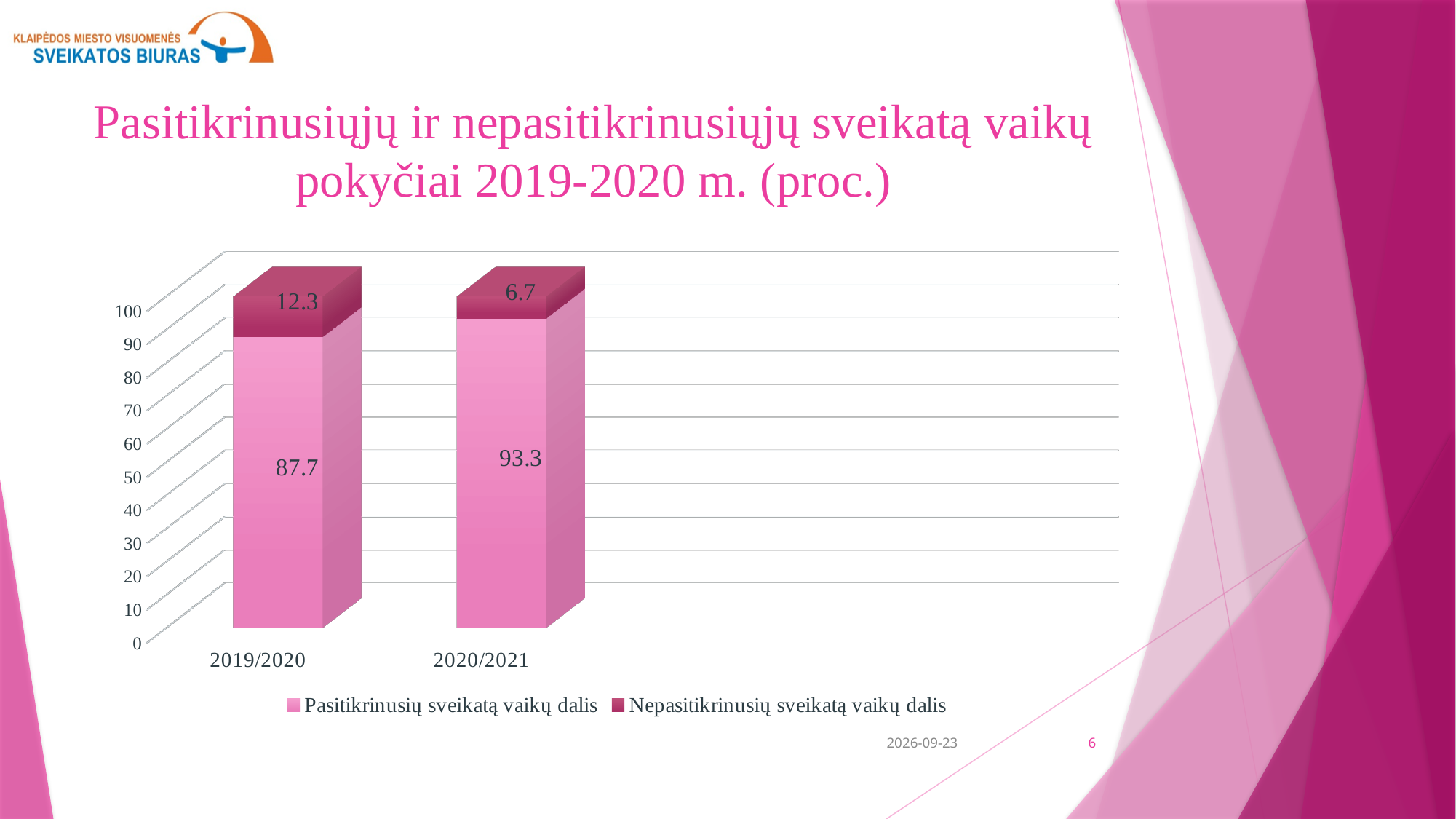
What is the value for 'Pasitikrinusių sveikatą vaikų dalis' in 2020/2021? 93.3 What is the value for 'Nepasitikrinusių sveikatą vaikų dalis' in 2019/2020? 12.3 Which year has the lower value for 'Nepasitikrinusių sveikatą vaikų dalis'? 2020/2021 What kind of chart is shown on the slide? Stacked bar chart What is the value for 'Nepasitikrinusių sveikatą vaikų dalis' in 2020/2021? 6.7 How many series does the legend list? 2 What is the value for 'Pasitikrinusių sveikatą vaikų dalis' in 2019/2020? 87.7 Is the 'Nepasitikrinusių sveikatą vaikų dalis' value larger in 2019/2020 or in 2020/2021? 2019/2020 Which year has the higher value for 'Pasitikrinusių sveikatą vaikų dalis'? 2020/2021 What is the difference between the 'Nepasitikrinusių sveikatą vaikų dalis' values for 2019/2020 and 2020/2021? 5.6 What is the difference between the 'Pasitikrinusių sveikatą vaikų dalis' values for 2020/2021 and 2019/2020? 5.6 How many categories are shown on the x axis? 2